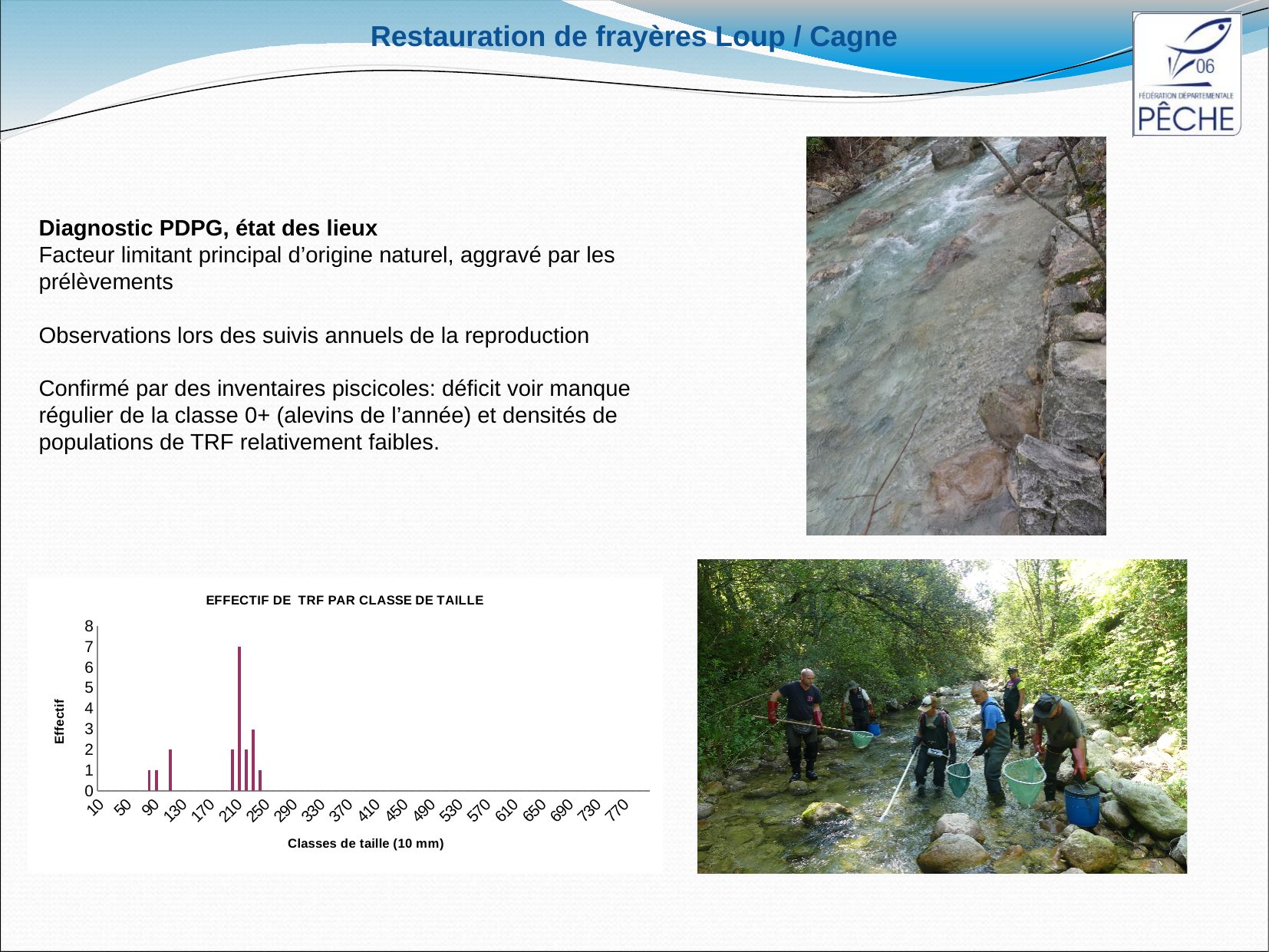
What is the label of the x axis of the chart? Classes de taille (10 mm) How many bars are plotted in the chart? 8 What is the title of the chart? EFFECTIF DE TRF PAR CLASSE DE TAILLE What kind of chart is shown on the slide? bar chart What is the smallest non-zero value reached by a bar in the chart? 1 Which size class has the tallest bar in the chart? 210 What is the difference between the tallest bar (7) and the bar reaching 3? 4 What is the value of the bar at size class 210? 7 Is the bar at size class 210 larger or smaller than the bar at size class 90? larger What is the highest value reached by any bar in the chart? 7 What is the highest tick value shown on the y axis of the chart? 8 Is the value of the tallest bar greater or less than 5? greater